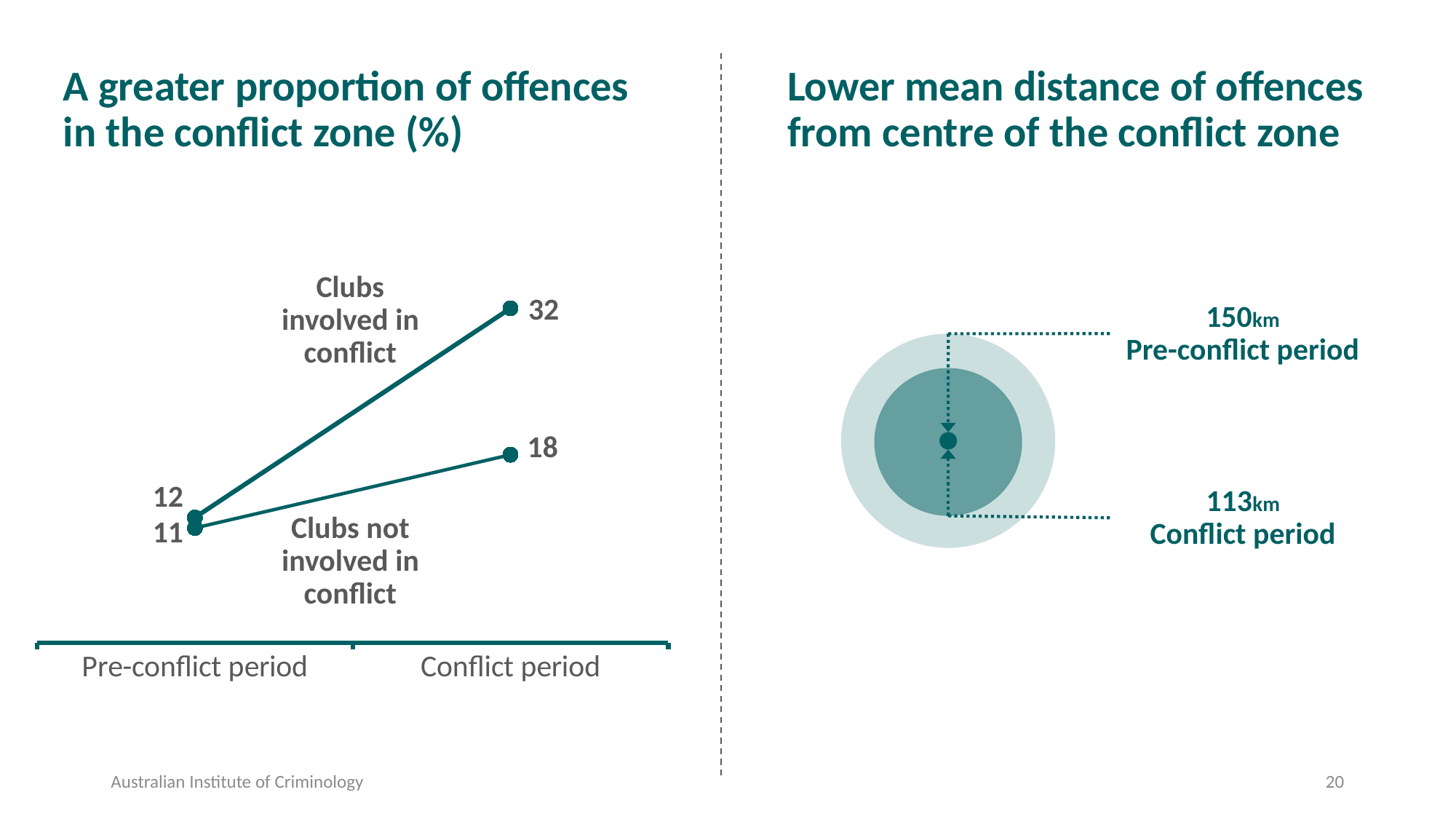
In the chart 'A greater proportion of offences in the conflict zone (%)', by how much did the value for clubs involved in conflict increase from the pre-conflict period to the conflict period? 20 In the chart 'A greater proportion of offences in the conflict zone (%)', what is the value for clubs involved in conflict in the pre-conflict period? 12 In the chart 'A greater proportion of offences in the conflict zone (%)', how many series are plotted? 2 What kind of chart is 'A greater proportion of offences in the conflict zone (%)'? Line chart In the chart 'A greater proportion of offences in the conflict zone (%)', what is the value for clubs not involved in conflict in the pre-conflict period? 11 In the diagram 'Lower mean distance of offences from centre of the conflict zone', what is the mean distance in the pre-conflict period? 150km In the chart 'A greater proportion of offences in the conflict zone (%)', which series has the higher value in the conflict period? Clubs involved in conflict In the chart 'A greater proportion of offences in the conflict zone (%)', what is the value for clubs involved in conflict in the conflict period? 32 In the chart 'A greater proportion of offences in the conflict zone (%)', what is the difference between the conflict period values for clubs involved in conflict and clubs not involved in conflict? 14 In the chart 'A greater proportion of offences in the conflict zone (%)', do the values rise or fall from the pre-conflict period to the conflict period? Rise In the chart 'A greater proportion of offences in the conflict zone (%)', how many periods are shown on the x axis? 2 In the chart 'A greater proportion of offences in the conflict zone (%)', what is the value for clubs not involved in conflict in the conflict period? 18